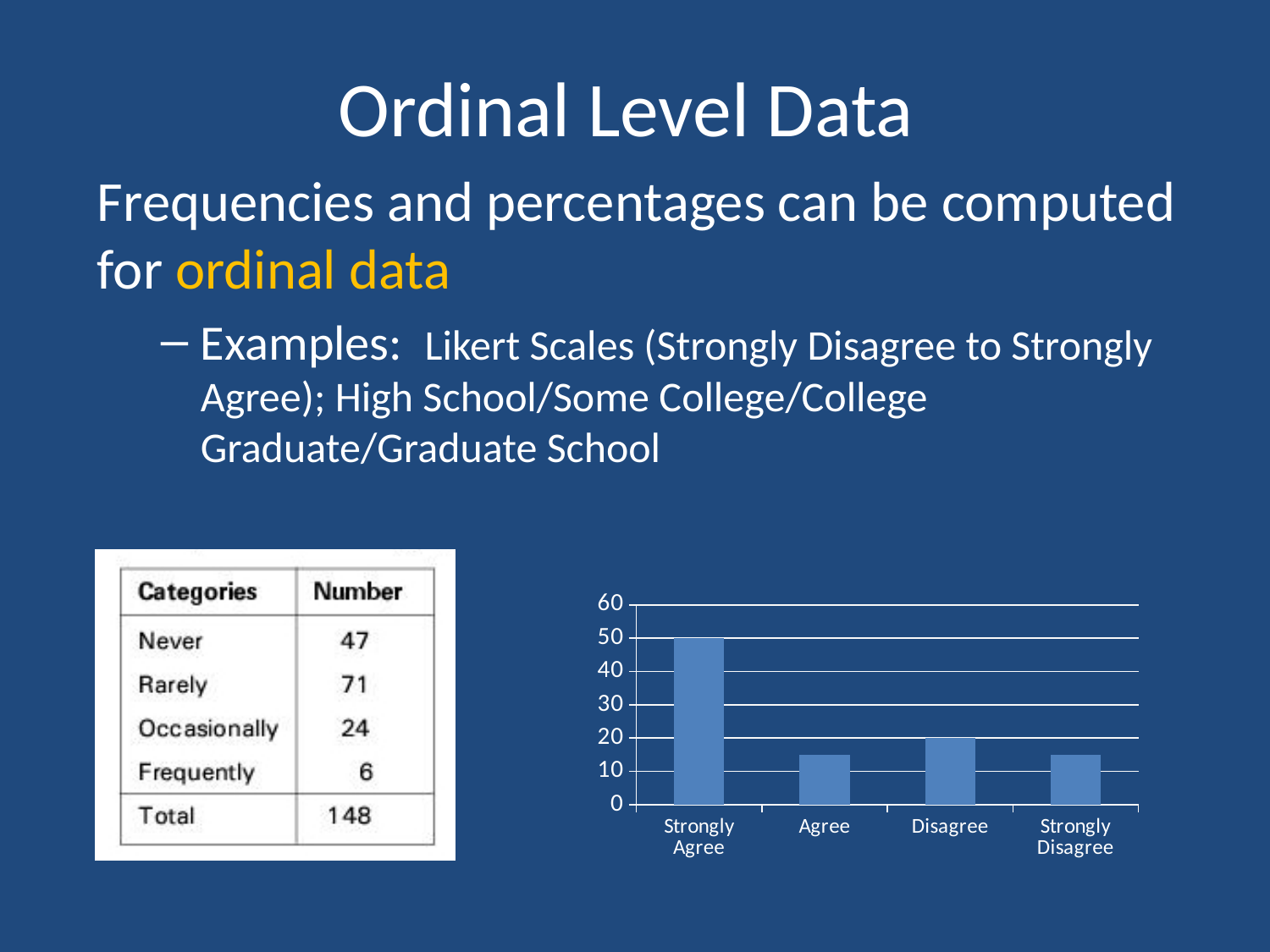
What is the value of the bar for Disagree? 20 Which is larger in the chart, Disagree or Agree? Disagree Is the value for Strongly Disagree greater or less than 10? greater What is the difference between the values for Strongly Agree and Disagree? 30 What is the highest value shown on the y axis of the bar chart? 60 What kind of chart is shown on the right side of the slide? bar chart What is the value of the bar for Strongly Agree? 50 Is the value for Agree greater or less than 20? less Which is larger in the chart, Strongly Agree or Disagree? Strongly Agree How many categories are shown on the x axis of the bar chart? 4 Is the value for Strongly Agree greater or less than 40? greater Which category has the highest bar in the chart? Strongly Agree